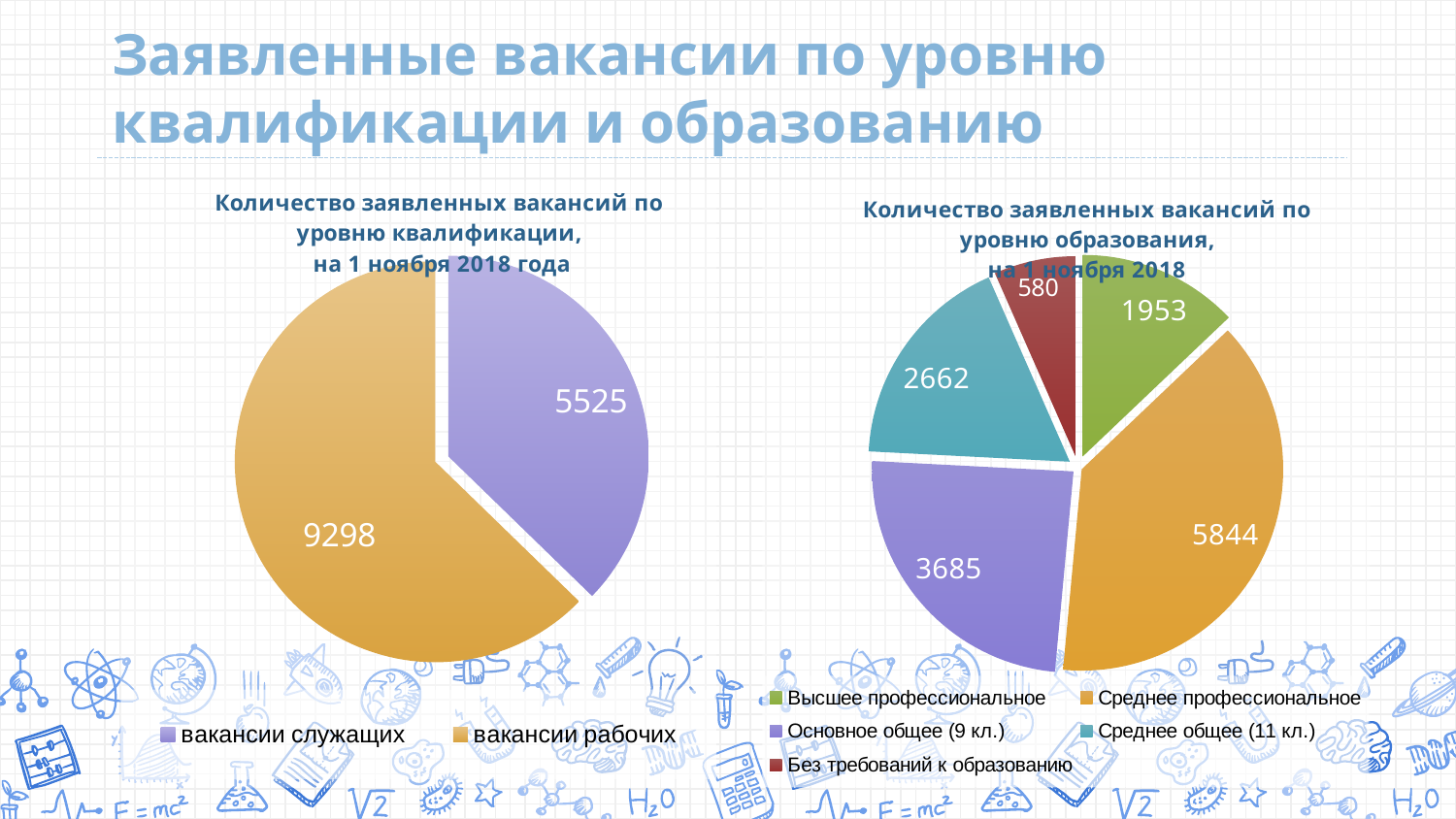
In the right chart (по уровню образования), which category has the largest number of vacancies? Среднее профессиональное In the right chart (по уровню образования), what is the difference between Среднее профессиональное and Основное общее (9 кл.)? 2159 In the left chart (по уровню квалификации), how many vacancies are for вакансии рабочих? 9298 In the left chart (по уровню квалификации), what is the difference between вакансии рабочих and вакансии служащих? 3773 In the right chart (по уровню образования), how many vacancies are for Среднее профессиональное? 5844 In the left chart (по уровню квалификации), how many vacancies are for вакансии служащих? 5525 In the right chart (по уровню образования), what colour is the slice for Без требований к образованию? Red In the right chart (по уровню образования), how many categories does the legend list? 5 In the right chart (по уровню образования), which category has the smallest number of vacancies? Без требований к образованию In the left chart (по уровню квалификации), what kind of chart is shown? Pie chart In the right chart (по уровню образования), how many vacancies are for Основное общее (9 кл.)? 3685 In the right chart (по уровню образования), which is larger: Среднее общее (11 кл.) or Высшее профессиональное? Среднее общее (11 кл.)